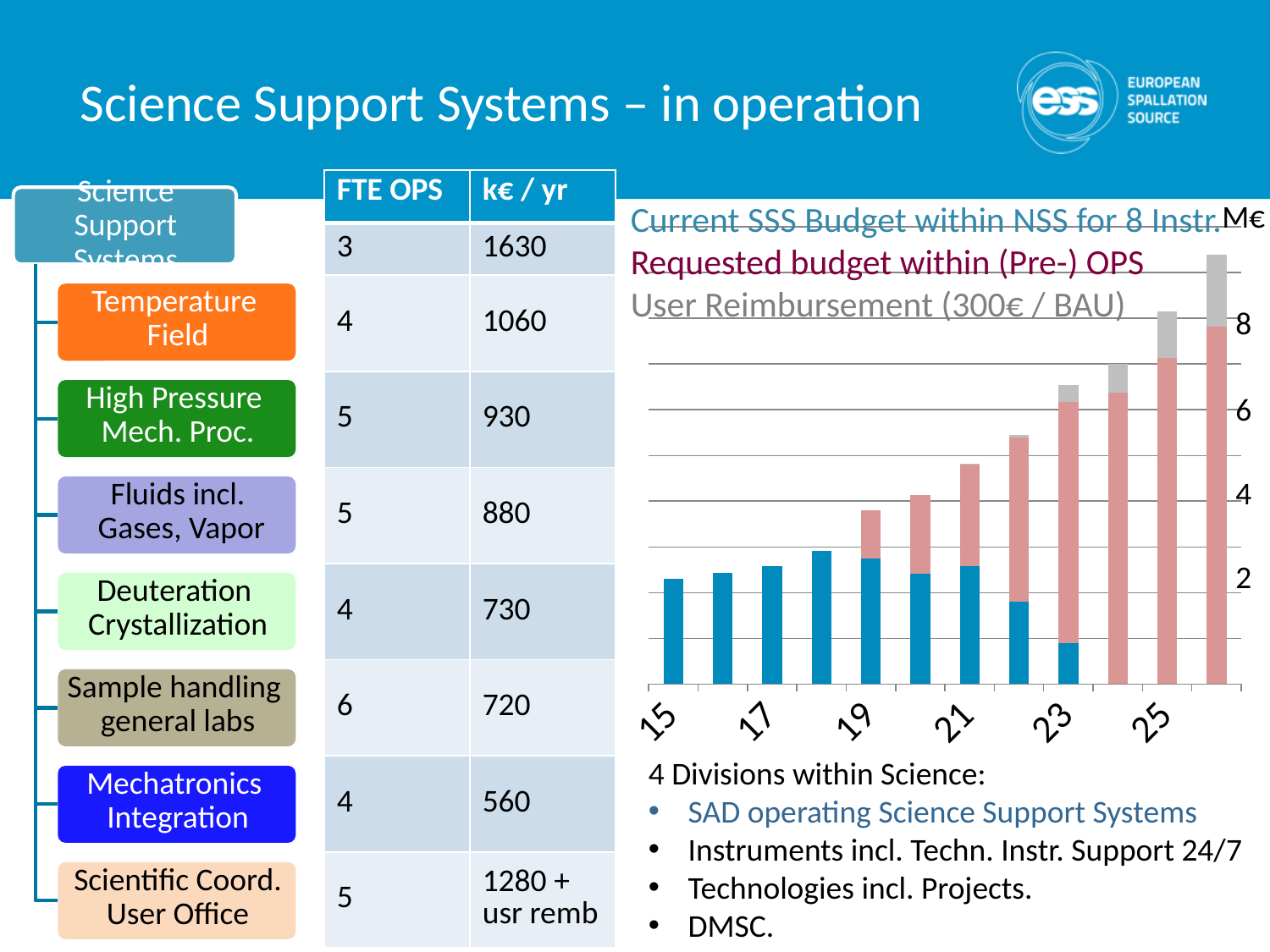
What kind of chart is shown on the slide? stacked bar chart How many series does the chart's legend list? 3 Is the total bar for year 19 greater or less than 4 M€? less What unit is shown at the top of the chart's vertical axis? M€ Which year has the larger total bar, 20 or 23? 23 Is the total bar for year 24 greater or less than 6 M€? greater Which legend entry is shown in blue in the chart? Current SSS Budget within NSS for 8 Instr. How many bars (years) are plotted in the chart? 12 Which year has the larger blue (Current SSS Budget) segment, 18 or 23? 18